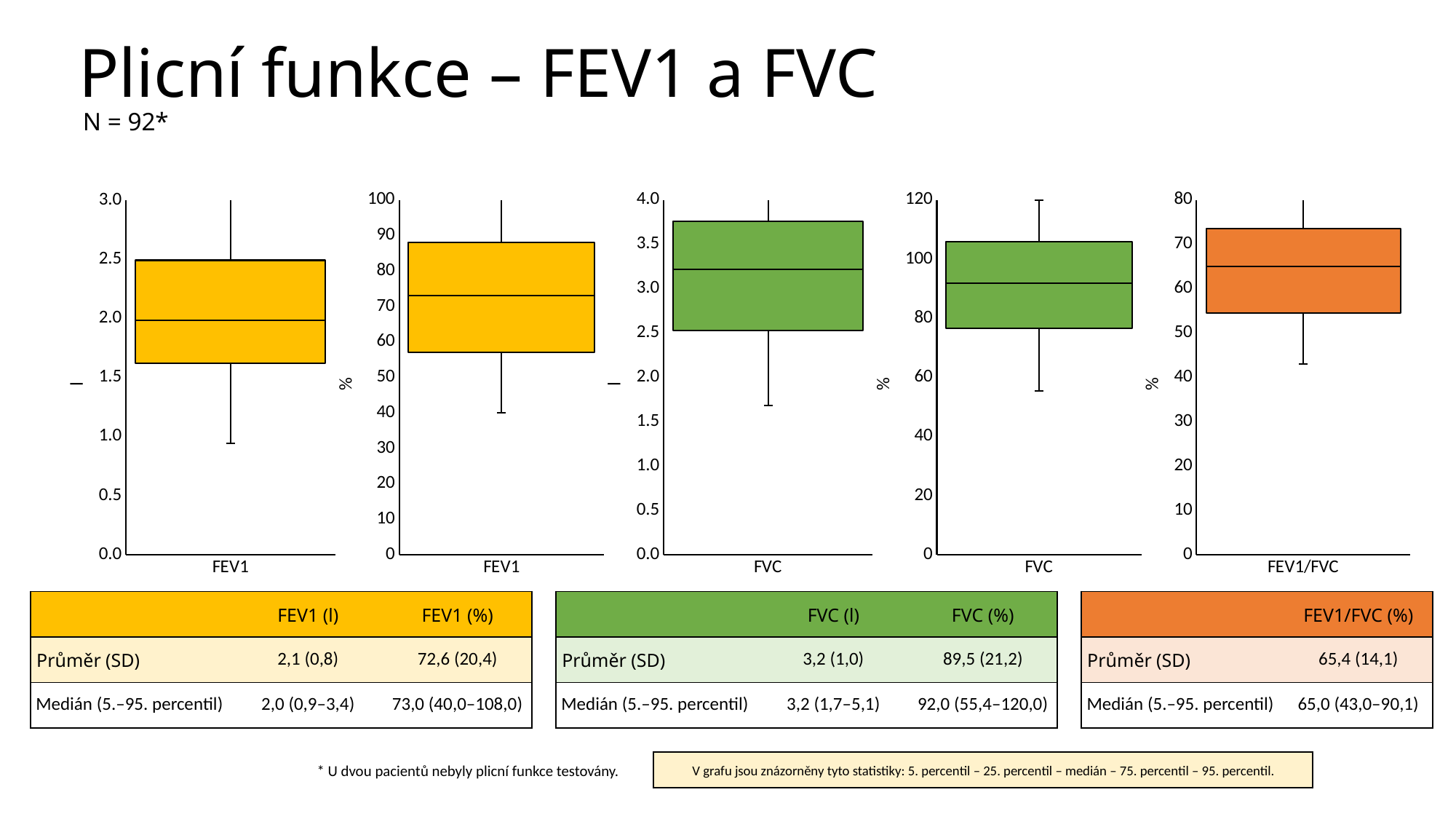
In the FEV1 (l) chart, what is the median value of FEV1? 2,0 What is the y-axis label of the first FVC chart (the one with a 0.0–4.0 scale)? l In the FVC (%) chart, what is the difference between the 95th percentile and the 5th percentile? 64,6 In the FEV1 (%) chart, is the median greater or less than 60? greater How many box plots are shown on the slide? 5 In the FEV1/FVC (%) chart, what is the 95th percentile value? 90,1 What kind of chart is used on this slide to show FEV1 and FVC? box plot What colour is the box in the FEV1/FVC chart? orange In the FVC (%) chart, what is the median value of FVC? 92,0 In the FVC (l) chart, is the 5th percentile (lower whisker) greater or less than 2.0? less In the FEV1 (%) chart, what is the 5th percentile value? 40,0 Which median is larger: FVC (%) or FEV1 (%)? FVC (%)